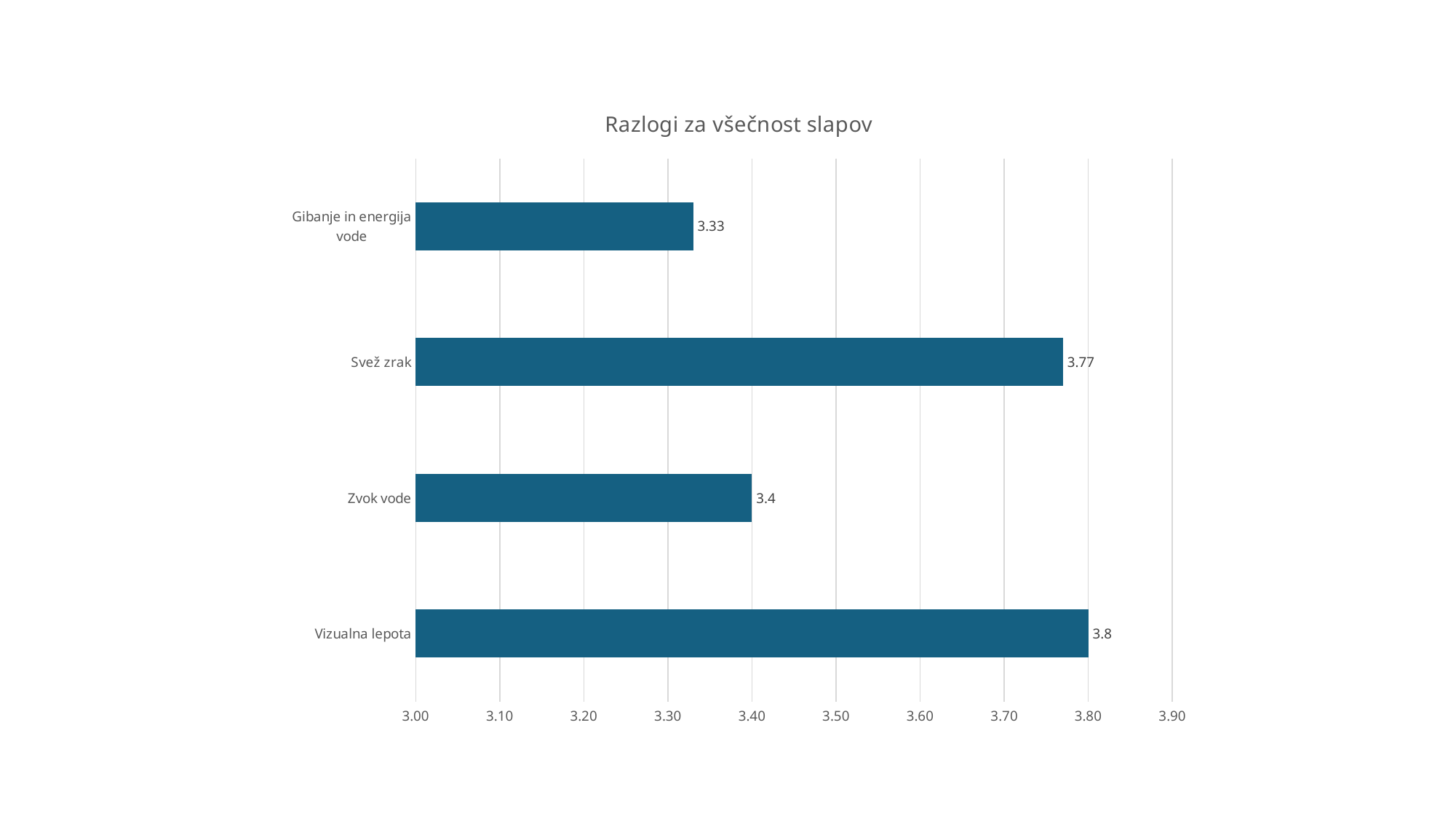
Which is larger, the value for Zvok vode or the value for Gibanje in energija vode? Zvok vode How many categories are shown in the chart? 4 What is the value for Gibanje in energija vode? 3.33 Which category has the highest value? Vizualna lepota What is the title of the chart? Razlogi za všečnost slapov What is the value for Svež zrak? 3.77 Is the value for Svež zrak greater or less than 3.50? greater What is the value for Vizualna lepota? 3.8 Which category has the lowest value? Gibanje in energija vode What is the value for Zvok vode? 3.4 What is the difference between the values for Svež zrak and Zvok vode? 0.37 What kind of chart is shown on the slide? Bar chart